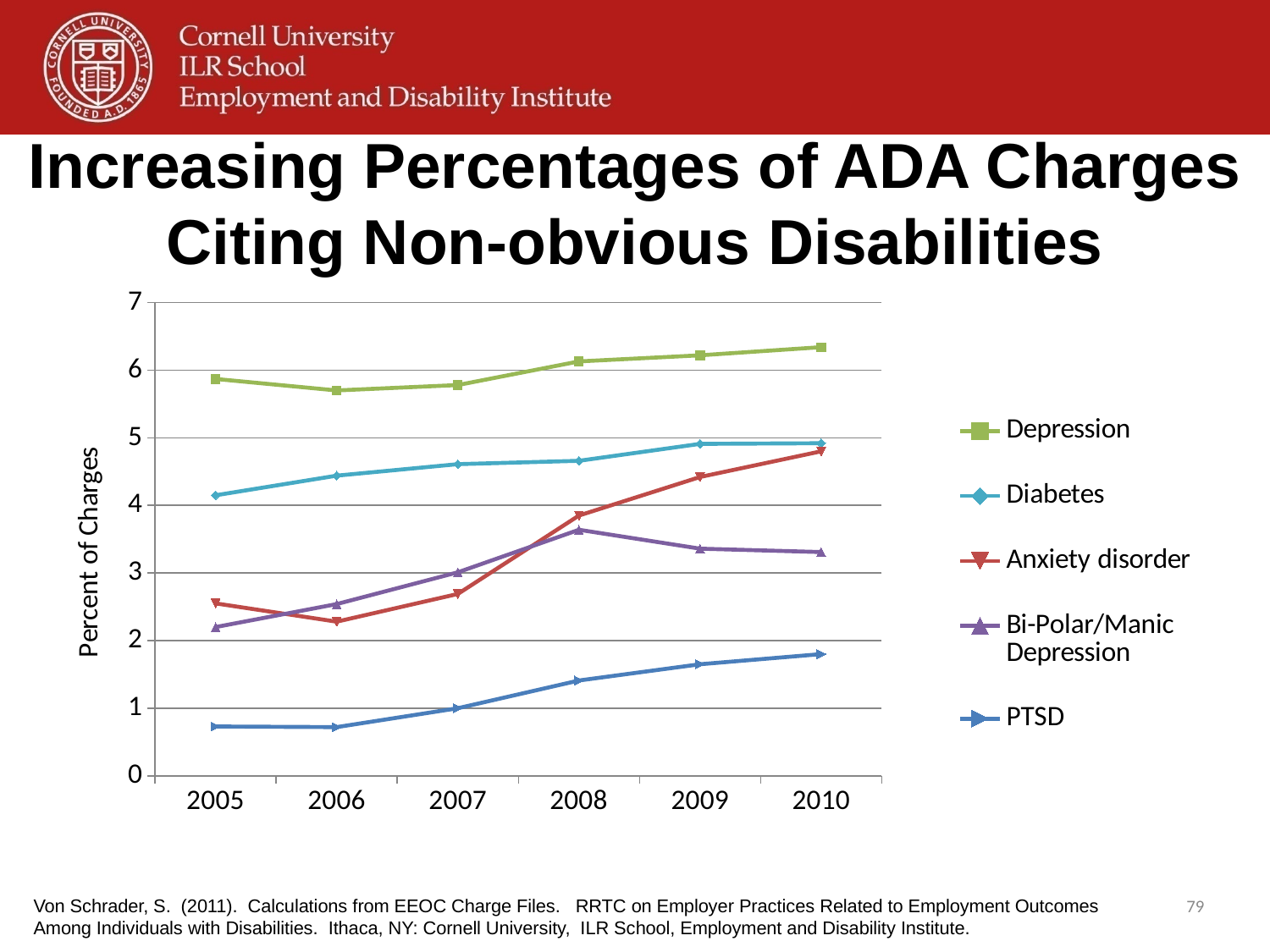
Which disability has the lowest percentage of charges in 2005? PTSD Is the value for Depression in 2010 greater or less than 6? greater Which disability has the highest percentage of charges in 2010? Depression What kind of chart is shown on the slide? line chart How many series does the legend list? 5 Is the value for PTSD in 2005 greater or less than 1? less In 2009, which is larger: Diabetes or Anxiety disorder? Diabetes Is the value for Anxiety disorder in 2008 greater or less than 3? greater What is the label on the y axis? Percent of Charges Does the PTSD line rise or fall from 2005 to 2010? rise In 2006, which is larger: Anxiety disorder or Bi-Polar/Manic Depression? Bi-Polar/Manic Depression How many years are shown along the x axis? 6